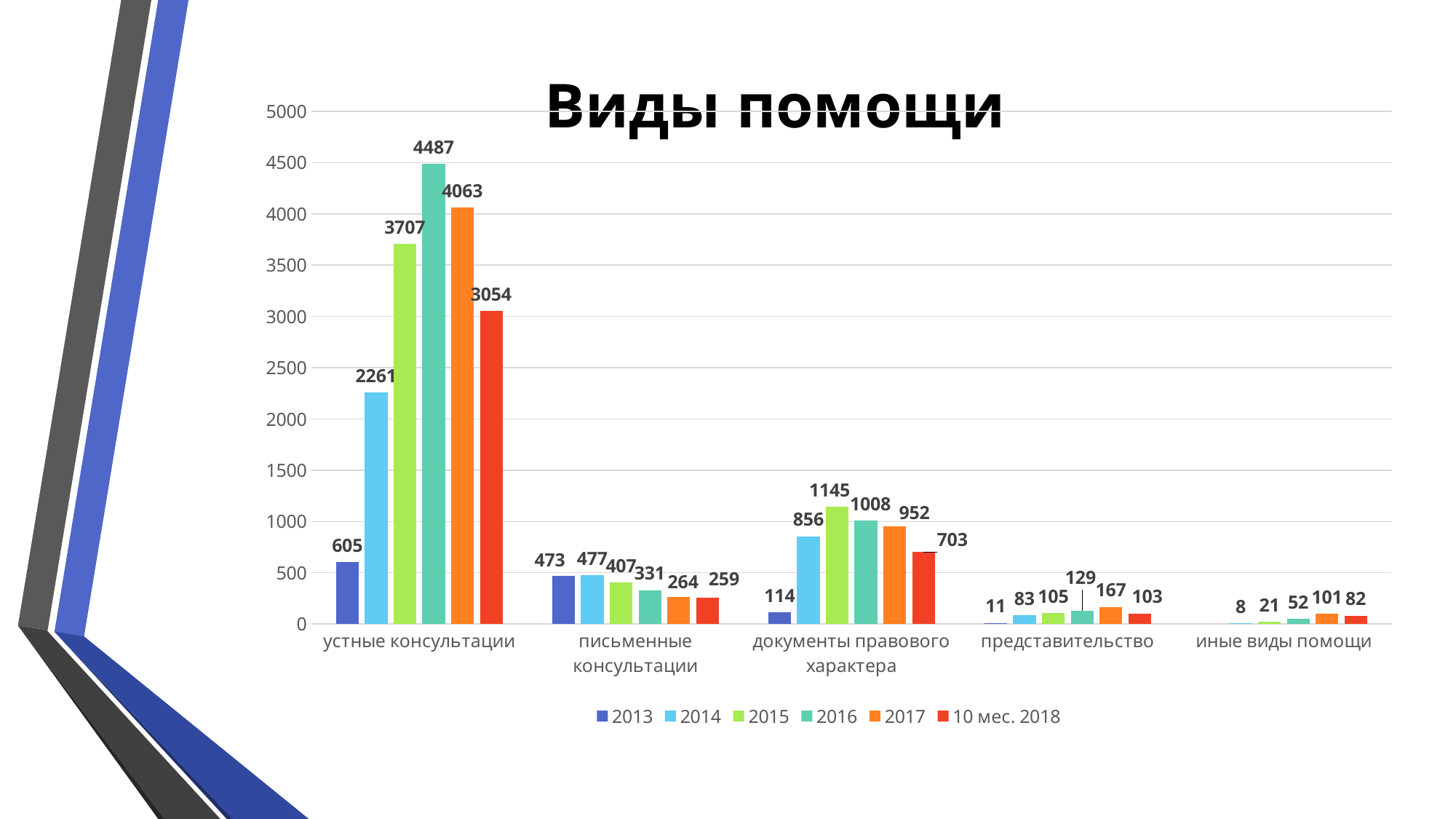
Which is larger in the документы правового характера category: the 2015 value or the 2016 value? 2015 Which year has the highest value in the устные консультации category? 2016 Is the 2014 value for устные консультации greater or less than 2000? greater What is the value for 2013 in the документы правового характера category? 114 How many series does the legend list? 6 What kind of chart is shown on the slide? bar chart How many categories are shown on the x axis? 5 Which year has the lowest value in the письменные консультации category? 10 мес. 2018 What is the value for 2017 in the представительство category? 167 What is the value for 2016 in the устные консультации category? 4487 What is the title of the chart? Виды помощи What is the difference between the 2016 and 2017 values in the устные консультации category? 424